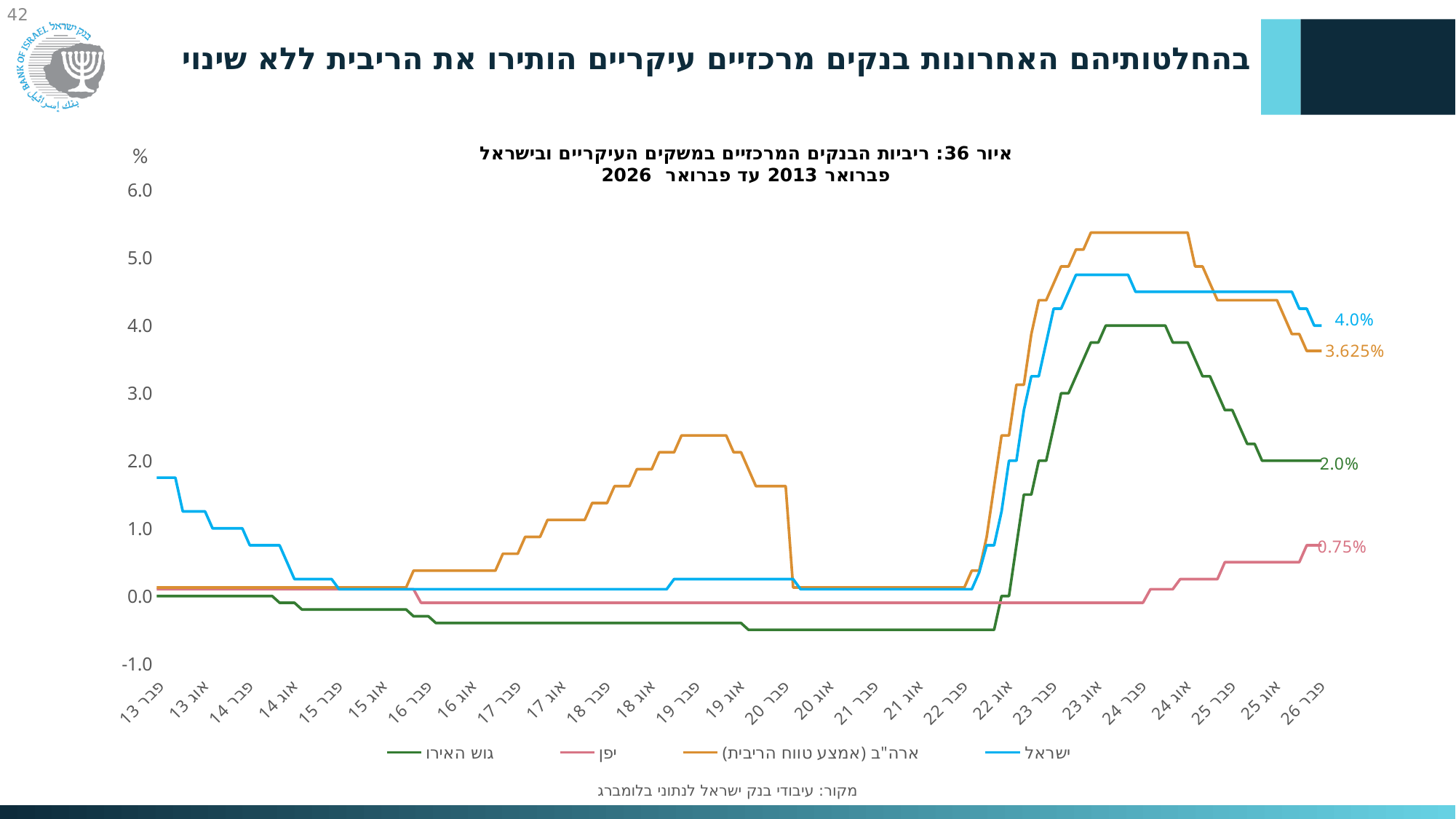
Which series has the lowest value at the right end of the chart (פבר 26)? יפן What is the latest value shown for ארה"ב (אמצע טווח הריבית) at the right end of the chart? 3.625% What kind of chart is shown on the slide? Line chart What is the latest value shown for יפן (Japan) at the right end of the chart? 0.75% What is the latest value shown for ישראל (Israel) at the right end of the chart? 4.0% What is the difference between the latest values of ישראל (4.0%) and גוש האירו (2.0%)? 2.0 percentage points How many series does the legend list? 4 Which series has the highest value at the right end of the chart (פבר 26)? ישראל Does the ישראל (Israel) series rise or fall between פבר 22 and פבר 23? Rise At the right end of the chart, which is larger: the value for ארה"ב or the value for גוש האירו? ארה"ב Is the peak value of the ארה"ב (US) series around 2023–2024 greater or less than 5.0? greater What is the latest value shown for גוש האירו (Euro area) at the right end of the chart? 2.0%